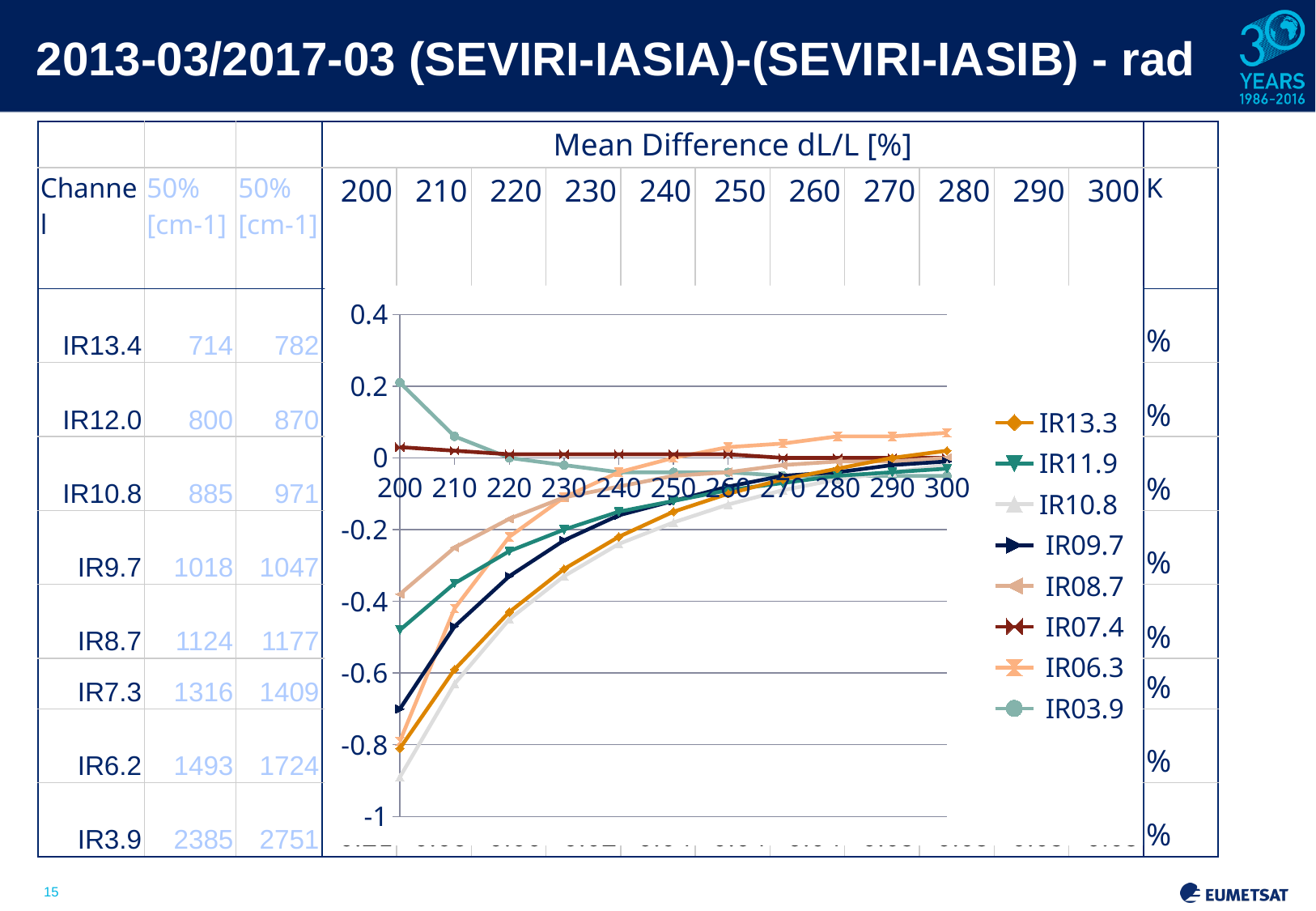
Is the value for IR03.9 at 200 K greater or less than 0? greater What kind of chart is shown on the slide? line chart Does the IR13.3 series rise or fall as the x-axis value increases from 200 to 300? rise Is the value for IR13.3 at 200 K greater or less than -0.6? less Which series has the lowest value at 200 K? IR10.8 How many x-axis values (temperatures) are plotted along the chart's x axis? 11 At 200 K, which series has the larger value, IR11.9 or IR09.7? IR11.9 What is the title shown above the chart? Mean Difference dL/L [%] Does the IR03.9 series rise or fall as the x-axis value increases from 200 to 300? fall How many series does the chart legend list? 8 Which series has the highest value at 200 K? IR03.9 Is the value for IR11.9 at 200 K greater or less than -0.6? greater